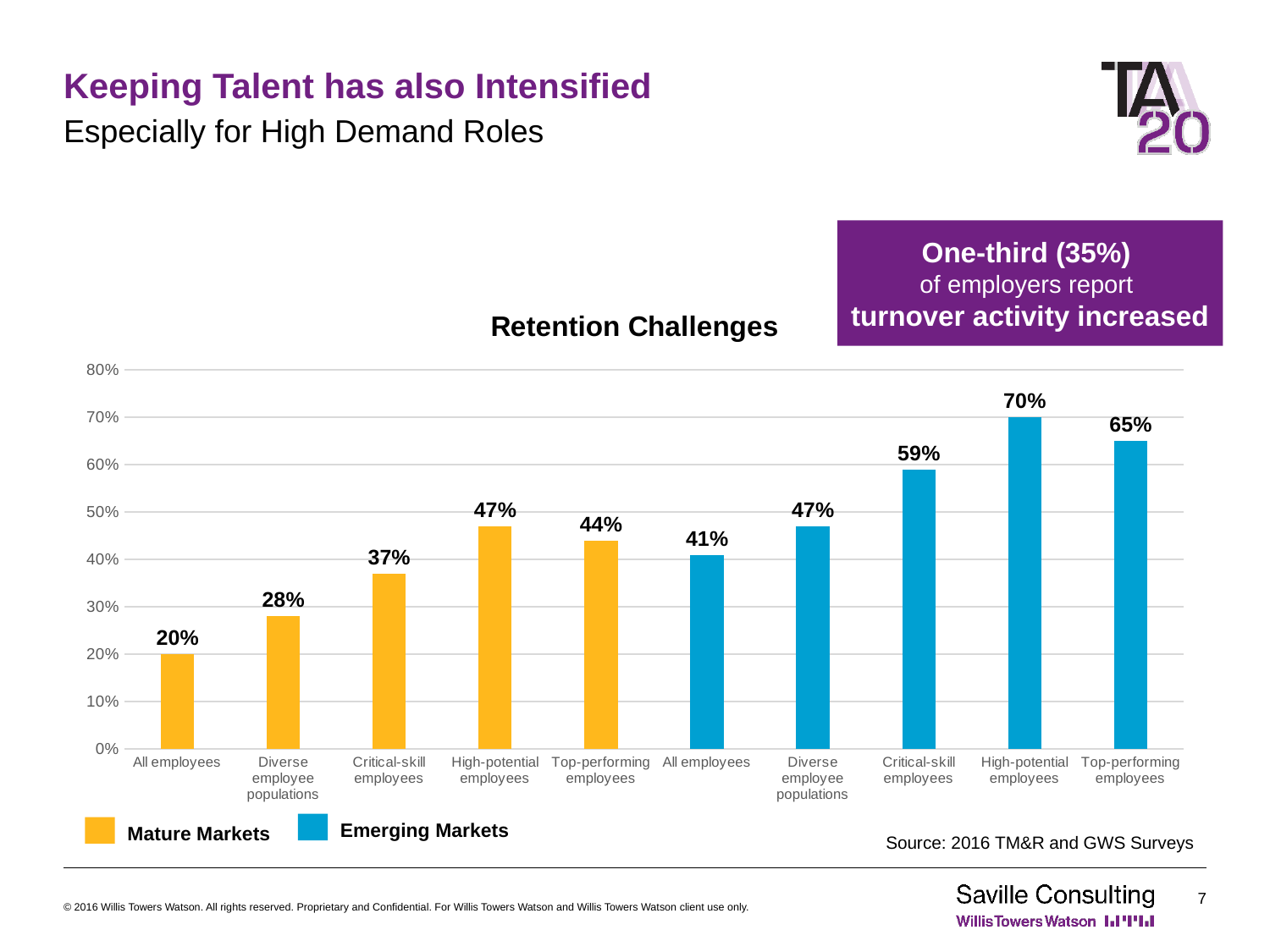
Is the value for Critical-skill employees in Mature Markets greater or less than 40%? less Which category has the highest value across the whole chart? High-potential employees (Emerging Markets) How many bars are plotted on the chart? 10 What is the difference between the Emerging Markets and Mature Markets values for Top-performing employees? 21% Which is larger: the Mature Markets value for Diverse employee populations or the Emerging Markets value for Diverse employee populations? Emerging Markets (47%) What is the value for All employees in Emerging Markets? 41% What is the value for Critical-skill employees in Emerging Markets? 59% How many series does the legend list? 2 Which category has the lowest value across the whole chart? All employees (Mature Markets) What kind of chart is shown? Bar chart What is the value for High-potential employees in Mature Markets? 47% What is the title of the chart? Retention Challenges